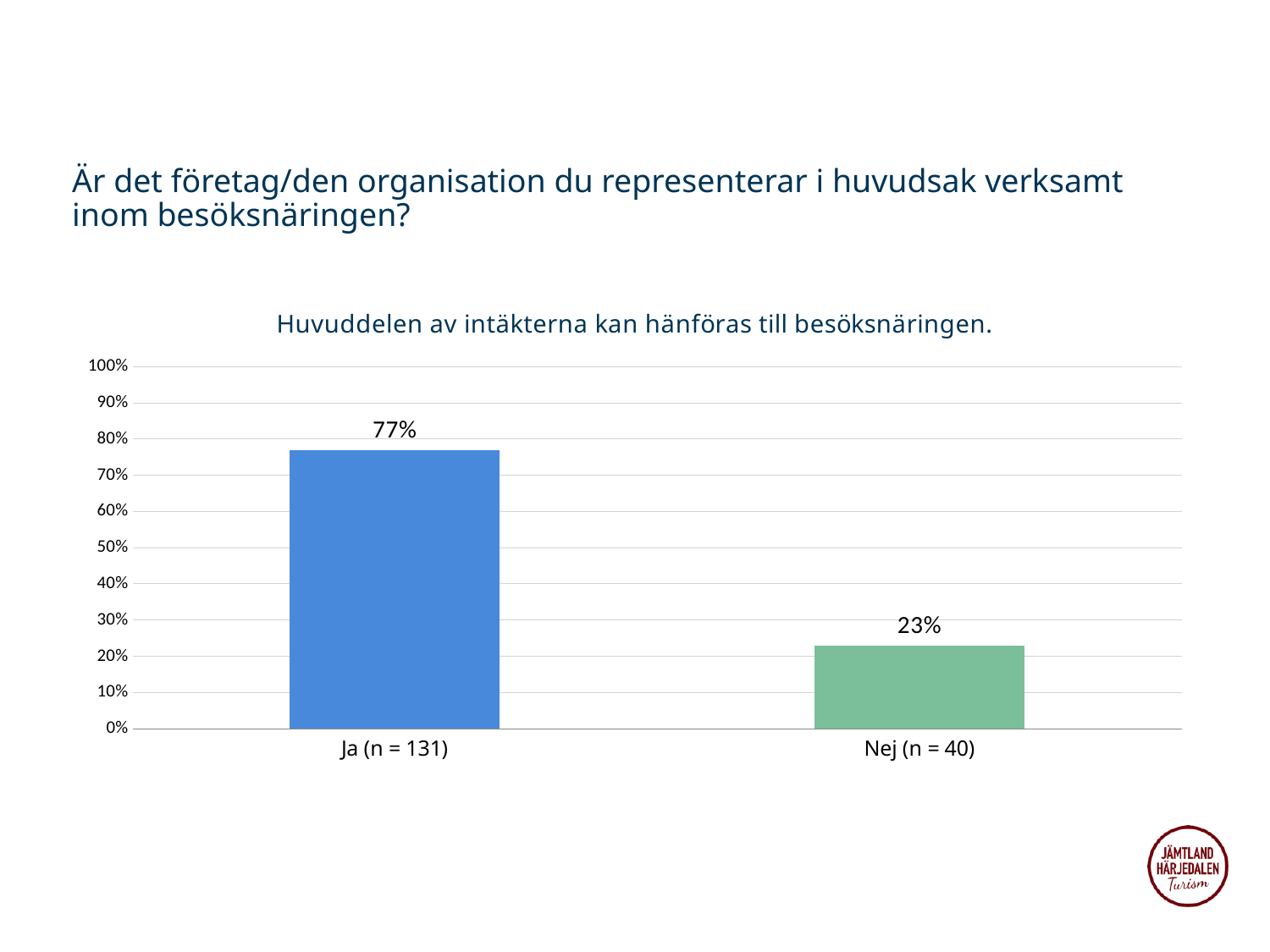
What kind of chart is shown on the slide? Bar chart What is the value for "Ja (n = 131)"? 77% What is the value for "Nej (n = 40)"? 23% Which category has the lowest value? Nej (n = 40) Which category has the highest value? Ja (n = 131) How many categories are shown in the chart? 2 Is the value for "Nej (n = 40)" greater or less than 30%? less What is the title of the chart? Huvuddelen av intäkterna kan hänföras till besöksnäringen. Which is larger, the value for "Ja (n = 131)" or the value for "Nej (n = 40)"? Ja (n = 131) What is the highest value shown on the vertical axis? 100% Is the value for "Ja (n = 131)" greater or less than 70%? greater What is the difference between the values for "Ja (n = 131)" and "Nej (n = 40)"? 54%